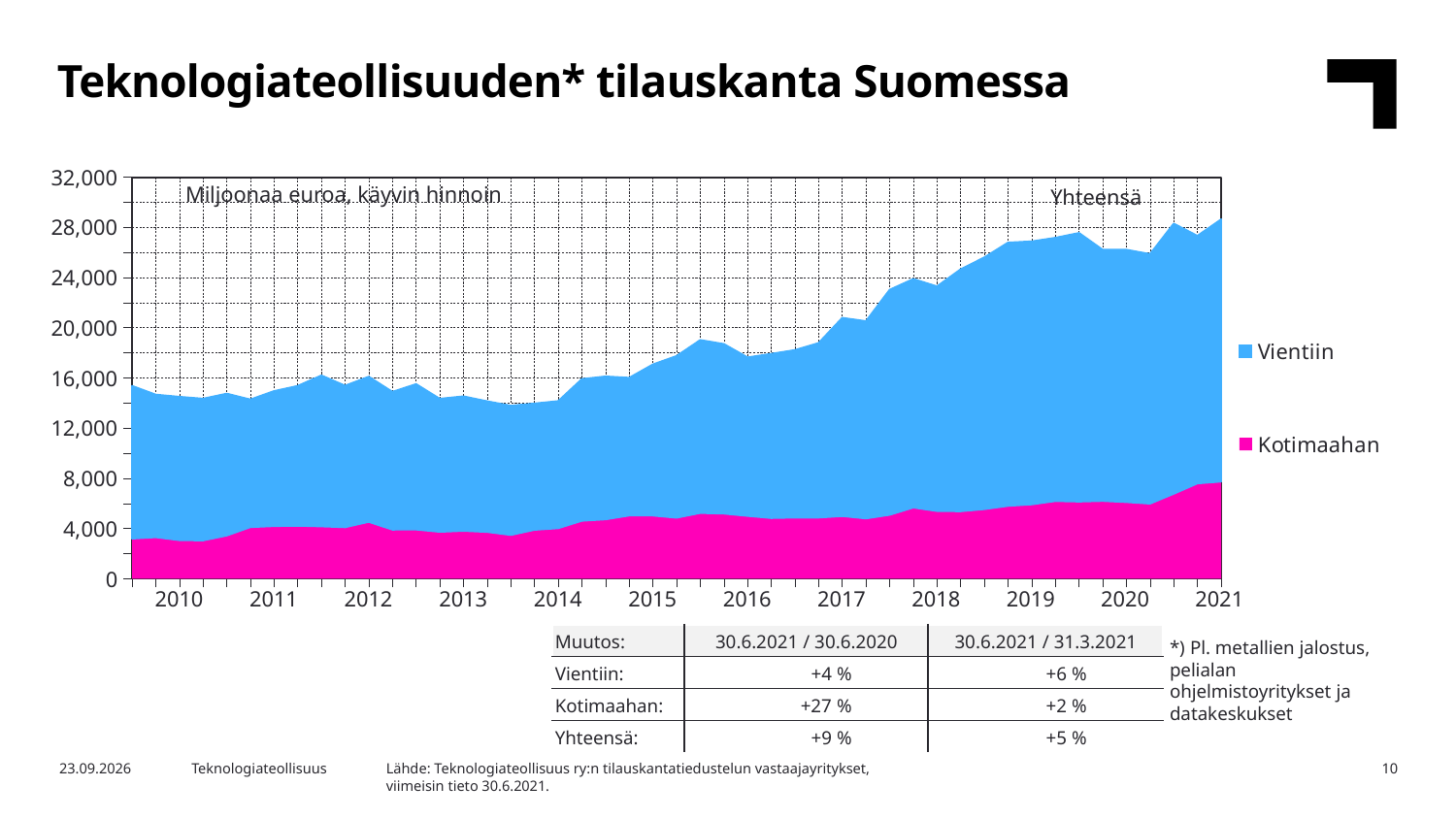
In 2021, which series is larger, Vientiin or Kotimaahan? Vientiin What kind of chart is shown on the slide? Stacked area chart Which two series are listed in the chart legend? Vientiin and Kotimaahan Does the total order backlog rise or fall between 2017 and 2019? Rises Is the Kotimaahan value at the end of the series in 2021 greater or less than 4,000? greater How many series does the chart legend list? 2 Is the Kotimaahan value at the start of 2010 greater or less than 4,000? less Does the Kotimaahan series generally rise or fall from 2010 to 2021? Rises Is the total order backlog (Yhteensä) in 2019 greater or less than 24,000? greater What is the title of the chart on the slide? Teknologiateollisuuden* tilauskanta Suomessa How many year labels are shown on the x axis? 12